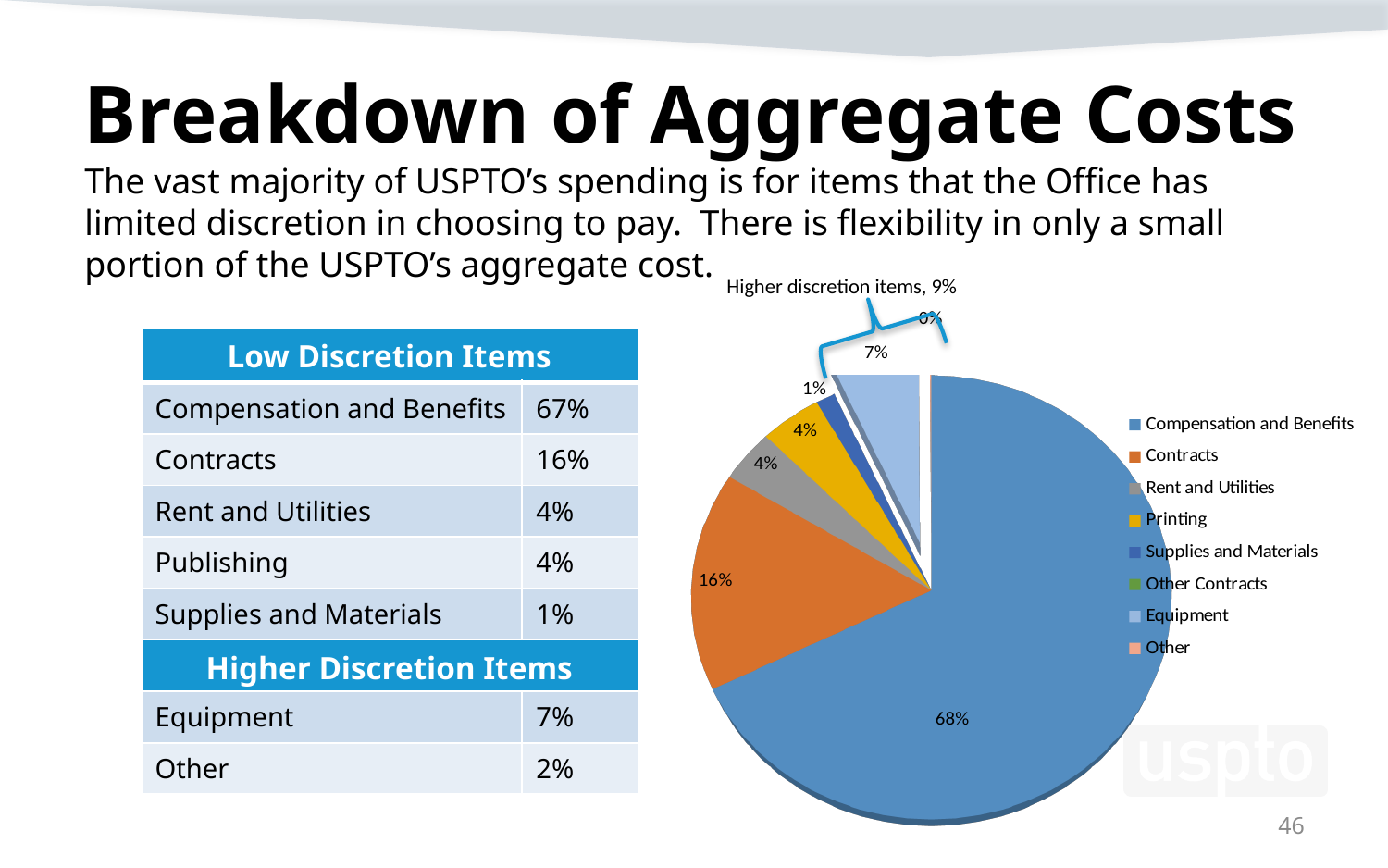
Which category has the largest slice of the pie chart? Compensation and Benefits In the pie chart, what percentage is shown for Contracts? 16% How many entries does the pie chart's legend list? 8 In the pie chart, what percentage is shown for Supplies and Materials? 1% What label does the bracket above the pie chart carry? Higher discretion items, 9% In the pie chart, what percentage is shown for Printing? 4% In the pie chart, what percentage is shown for Compensation and Benefits? 68% In the pie chart, what percentage is shown for Equipment? 7% In the pie chart, what is the difference between the Compensation and Benefits share and the Contracts share? 52% In the pie chart, which slice is larger: Contracts or Equipment? Contracts What colour is the Contracts slice in the pie chart? orange What kind of chart is shown on the slide? pie chart